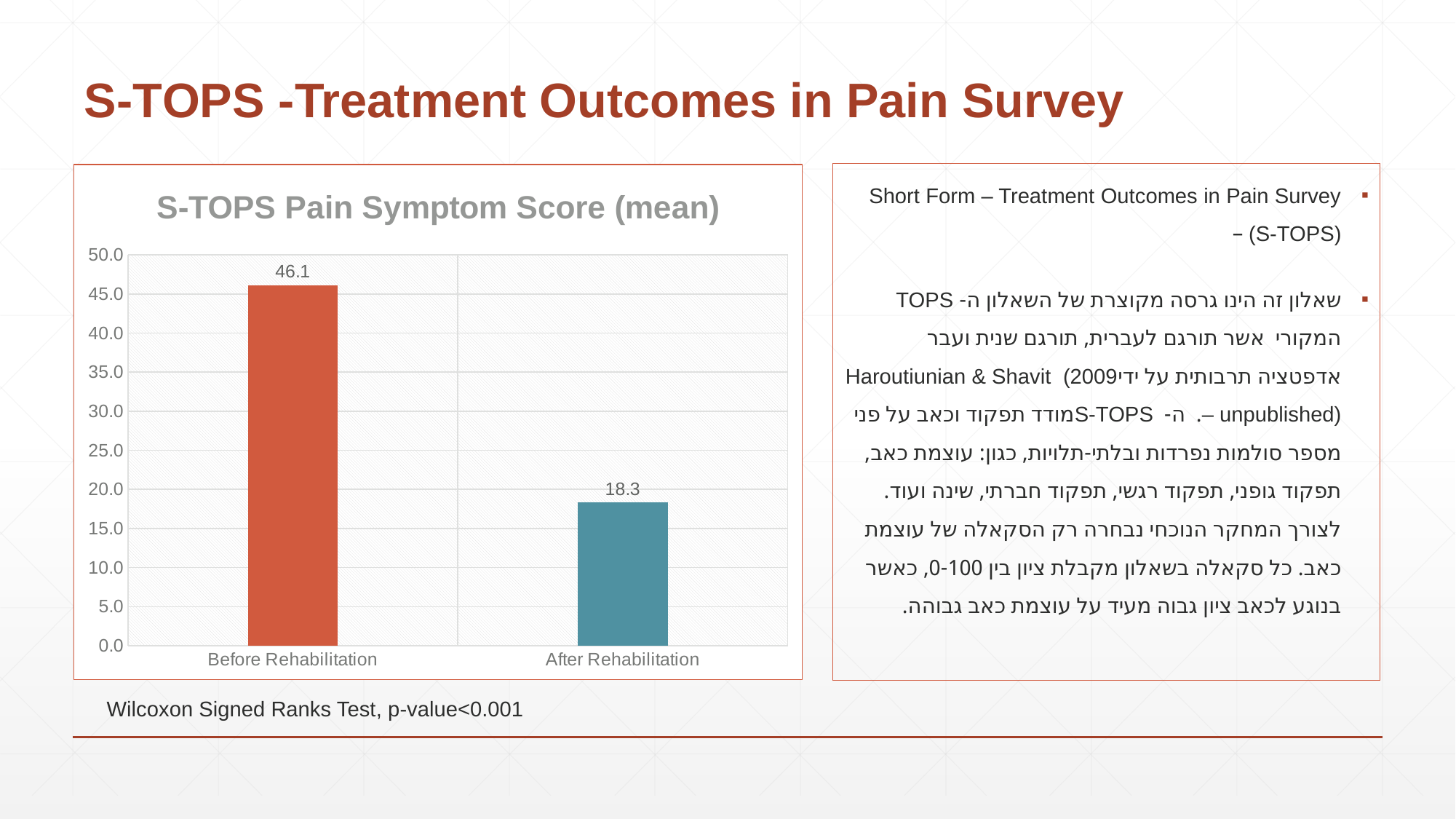
Which category has the highest S-TOPS Pain Symptom Score? Before Rehabilitation What is the difference between the before and after rehabilitation pain symptom scores? 27.8 What is the title of the chart? S-TOPS Pain Symptom Score (mean) What kind of chart is shown on the slide? Bar chart Is the value for After Rehabilitation greater or less than 20.0? less What is the mean S-TOPS Pain Symptom Score after rehabilitation? 18.3 Is the value for Before Rehabilitation greater or less than 45.0? greater How many categories are shown on the chart? 2 Is the pain symptom score larger before or after rehabilitation? Before Rehabilitation What is the mean S-TOPS Pain Symptom Score before rehabilitation? 46.1 Do the values rise or fall from Before Rehabilitation to After Rehabilitation? Fall Which category has the lowest S-TOPS Pain Symptom Score? After Rehabilitation